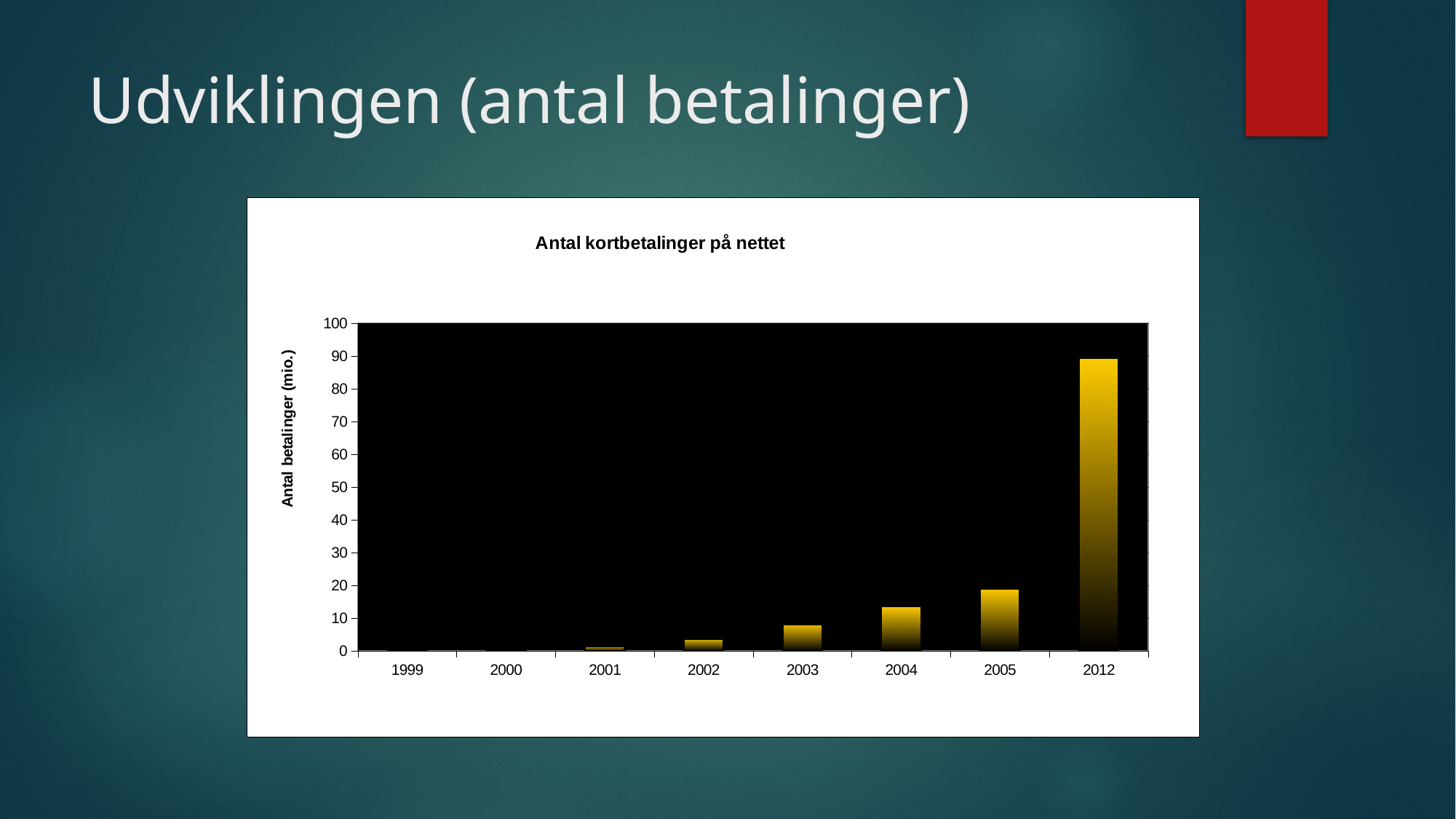
Do the values rise or fall from 1999 to 2012? rise Is the value for 2004 greater or less than 10? greater Which is larger, the value for 2002 or the value for 2003? 2003 Is the value for 2003 greater or less than 10? less Is the value for 2012 greater or less than 80? greater What is the title of the chart? Antal kortbetalinger på nettet What kind of chart is shown on the slide? bar chart Which year has the highest number of card payments? 2012 What is the label on the vertical axis of the chart? Antal betalinger (mio.) Which is larger, the value for 2005 or the value for 2004? 2005 How many years are shown on the x axis of the chart? 8